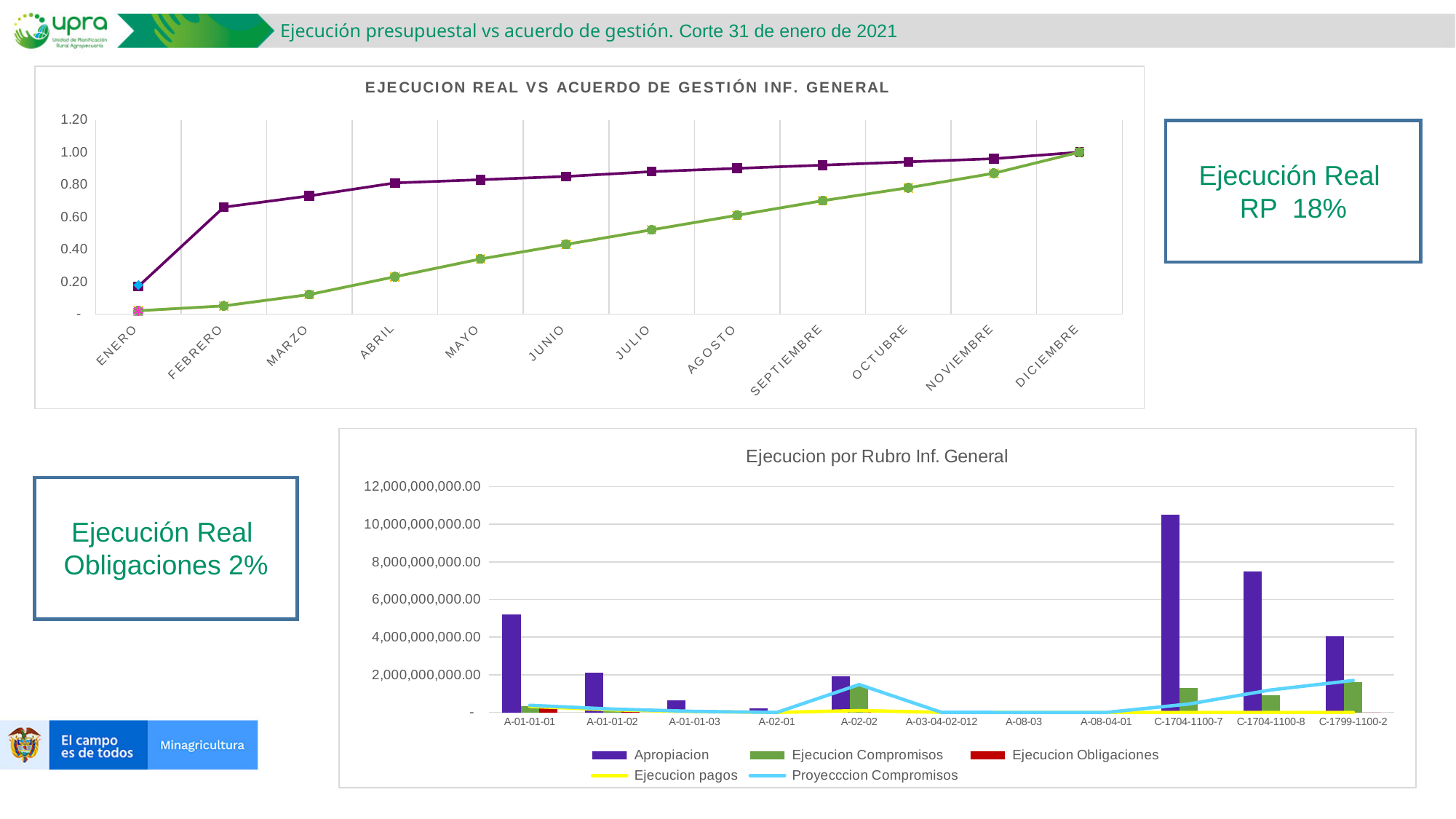
In the top chart, does the green line rise or fall from ENERO to DICIEMBRE? rise In the bottom chart, how many categories are shown on the x axis? 11 In the bottom chart, which series is shown in yellow according to the legend? Ejecucion pagos In the top chart, is the purple line's value for FEBRERO greater or less than 0.60? greater In the top chart, 'EJECUCION REAL VS ACUERDO DE GESTIÓN INF. GENERAL', what kind of chart is shown? line chart In the top chart, is the green line's value for JUNIO greater or less than 0.60? less In the bottom chart, how many series does the legend list? 5 In the top chart, which line is higher in MARZO, the purple line or the green line? the purple line In the top chart, how many months are shown along the x axis? 12 In the bottom chart, is the Apropiacion value for C-1704-1100-7 greater or less than 10,000,000,000.00? greater In the bottom chart, which category has the highest Apropiacion bar? C-1704-1100-7 In the bottom chart, 'Ejecucion por Rubro Inf. General', what kind of chart is shown? combination bar and line chart